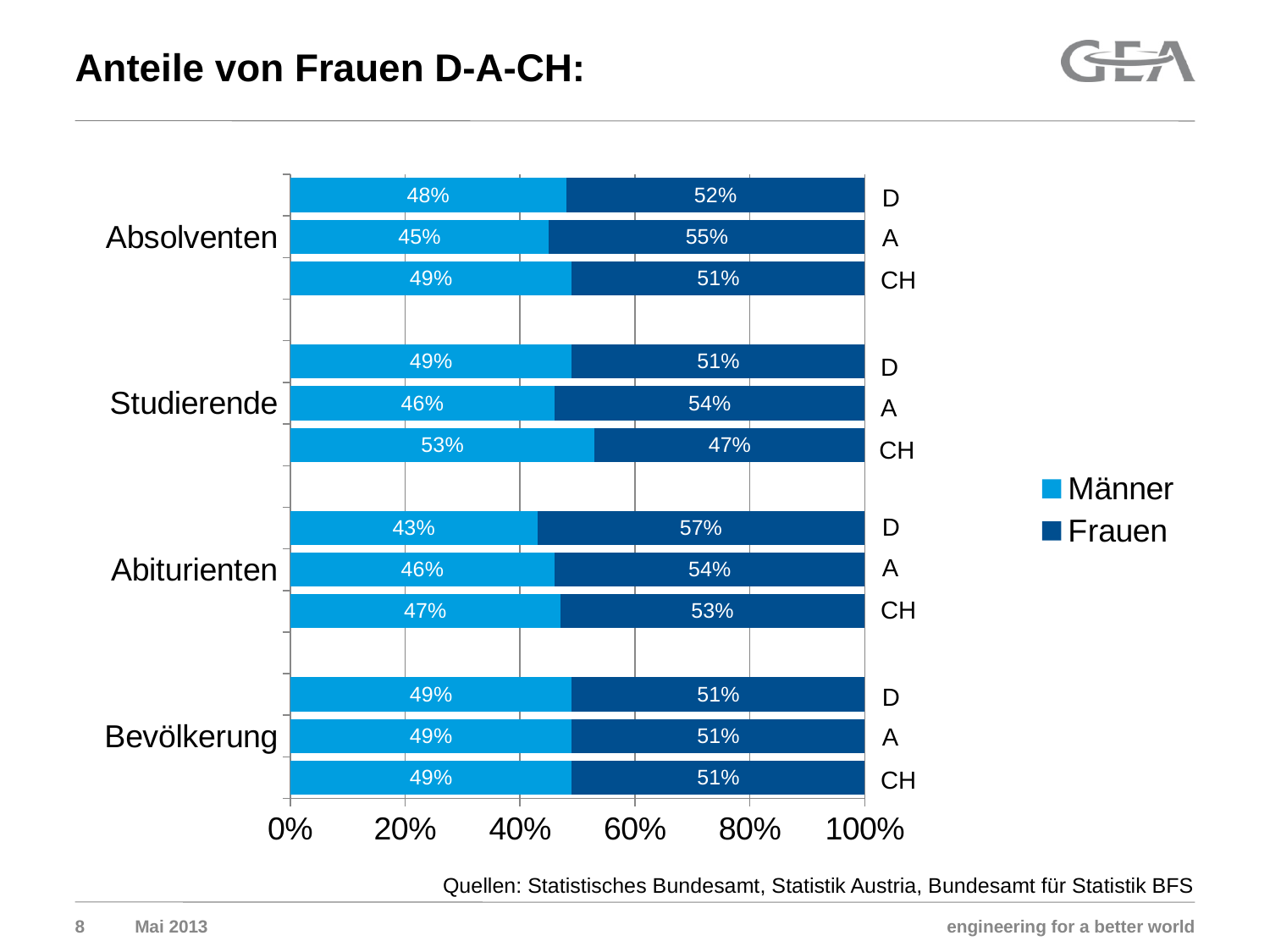
What is the difference between the Frauen share and the Männer share for Abiturienten in D? 14% Which bar has the lowest Frauen share? Studierende CH How many bars are plotted in the chart? 12 What is the total of the stacked bar for Bevölkerung in D? 100% What is the Männer share for Studierende in CH? 53% What is the Frauen share for Abiturienten in D? 57% How many series does the legend list? 2 What is the Frauen share for Absolventen in A? 55% What kind of chart is shown on the slide? Stacked bar chart Which series is shown in dark blue in the legend? Frauen Which bar has the highest Frauen share? Abiturienten D Is the Frauen share larger for Absolventen in A or for Absolventen in CH? Absolventen A